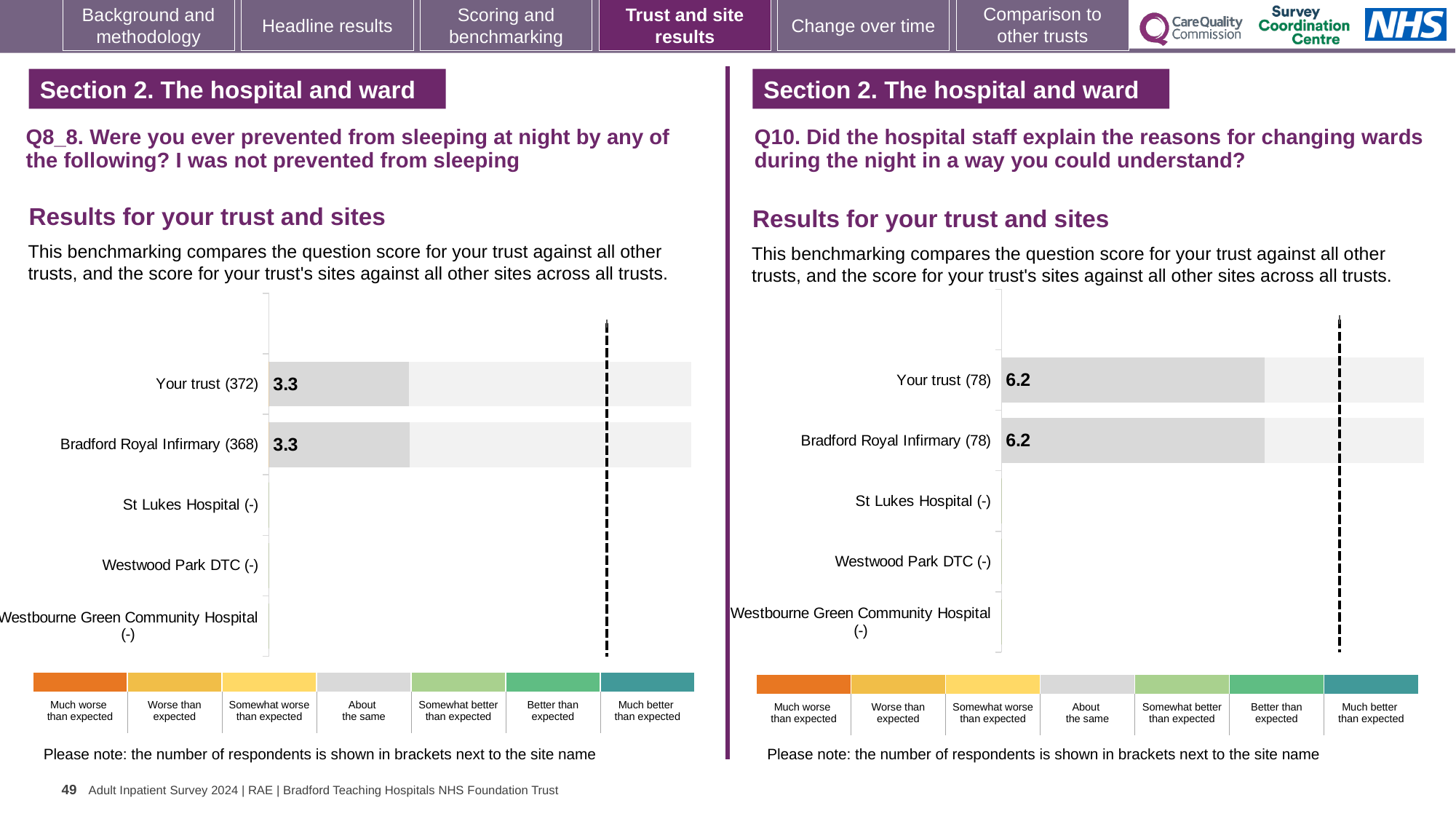
In the Q8_8 chart on the left, how many respondents are shown in brackets for Bradford Royal Infirmary? 368 How many site/trust categories are listed on the y axis of the Q10 chart on the right? 5 In the Q8_8 chart on the left, what is the score for Bradford Royal Infirmary? 3.3 In the Q8_8 chart on the left, how many respondents are shown in brackets for Your trust? 372 In the Q8_8 chart on the left, what is the score for Your trust? 3.3 In the Q10 chart on the right, what is the difference between the scores for Your trust and Bradford Royal Infirmary? 0 How many site/trust categories are listed on the y axis of the Q8_8 chart on the left? 5 In the Q10 chart on the right, what is the score for Bradford Royal Infirmary? 6.2 In the Q8_8 chart on the left, what is the difference between the scores for Your trust and Bradford Royal Infirmary? 0 In the Q10 chart on the right, what is the score for Your trust? 6.2 In the Q10 chart on the right, how many respondents are shown in brackets for Bradford Royal Infirmary? 78 What kind of chart is used for the Q10 results on the right? Bar chart